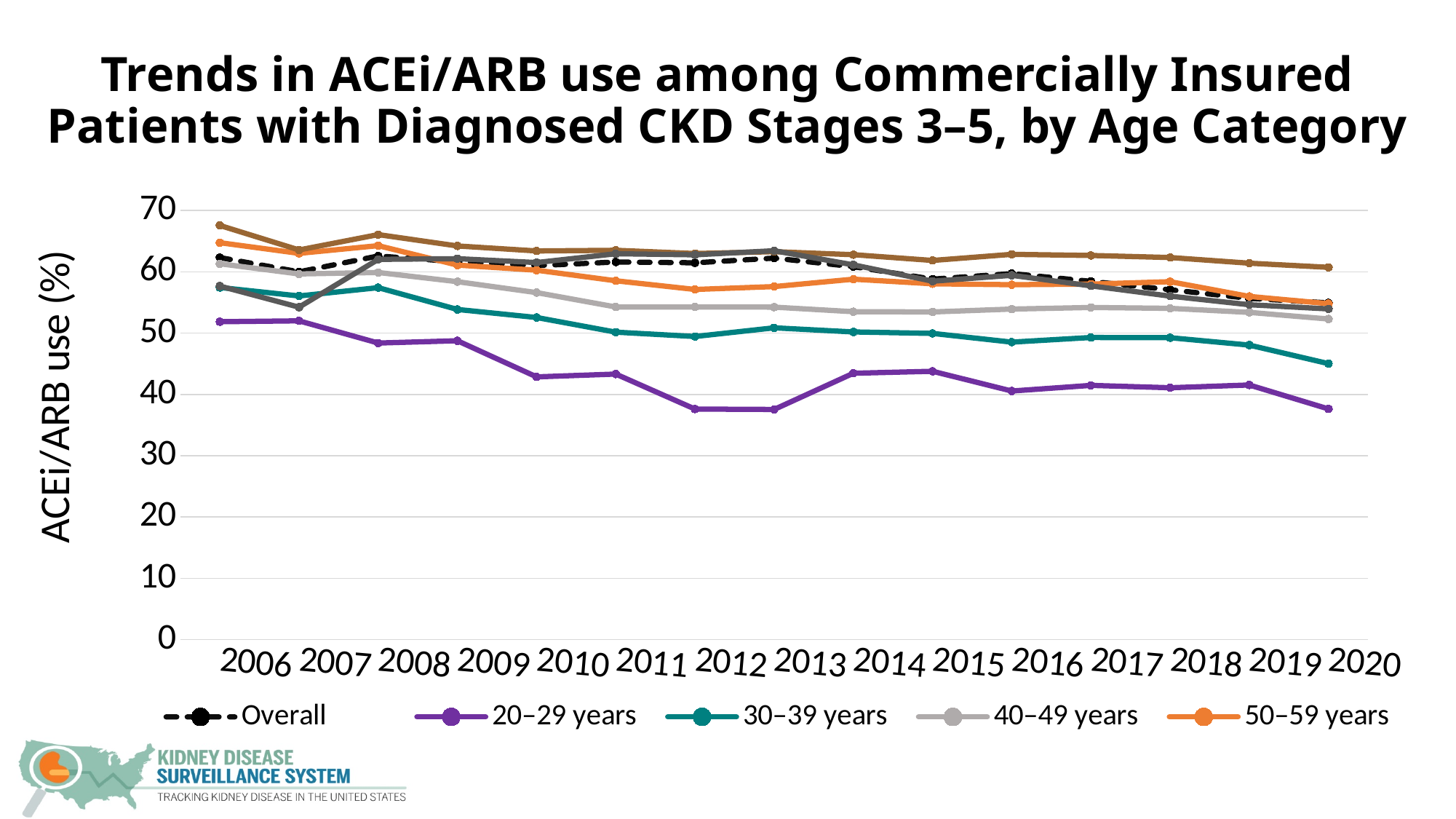
In 2020, which is higher: the value for 30–39 years or the value for 20–29 years? 30–39 years What is the label of the y axis? ACEi/ARB use (%) How many years are plotted along the x axis? 15 Does the value for 30–39 years rise or fall from 2006 to 2020? fall Does the value for 20–29 years rise or fall from 2006 to 2020? fall How many series does the legend list? 5 Which age group listed in the legend has the lowest ACEi/ARB use across all years? 20–29 years Is the value for 30–39 years in 2020 greater or less than 50? less What kind of chart is shown on the slide? line chart Is the value for 50–59 years in 2006 greater or less than 60? greater Is the value for 20–29 years in 2012 greater or less than 40? less